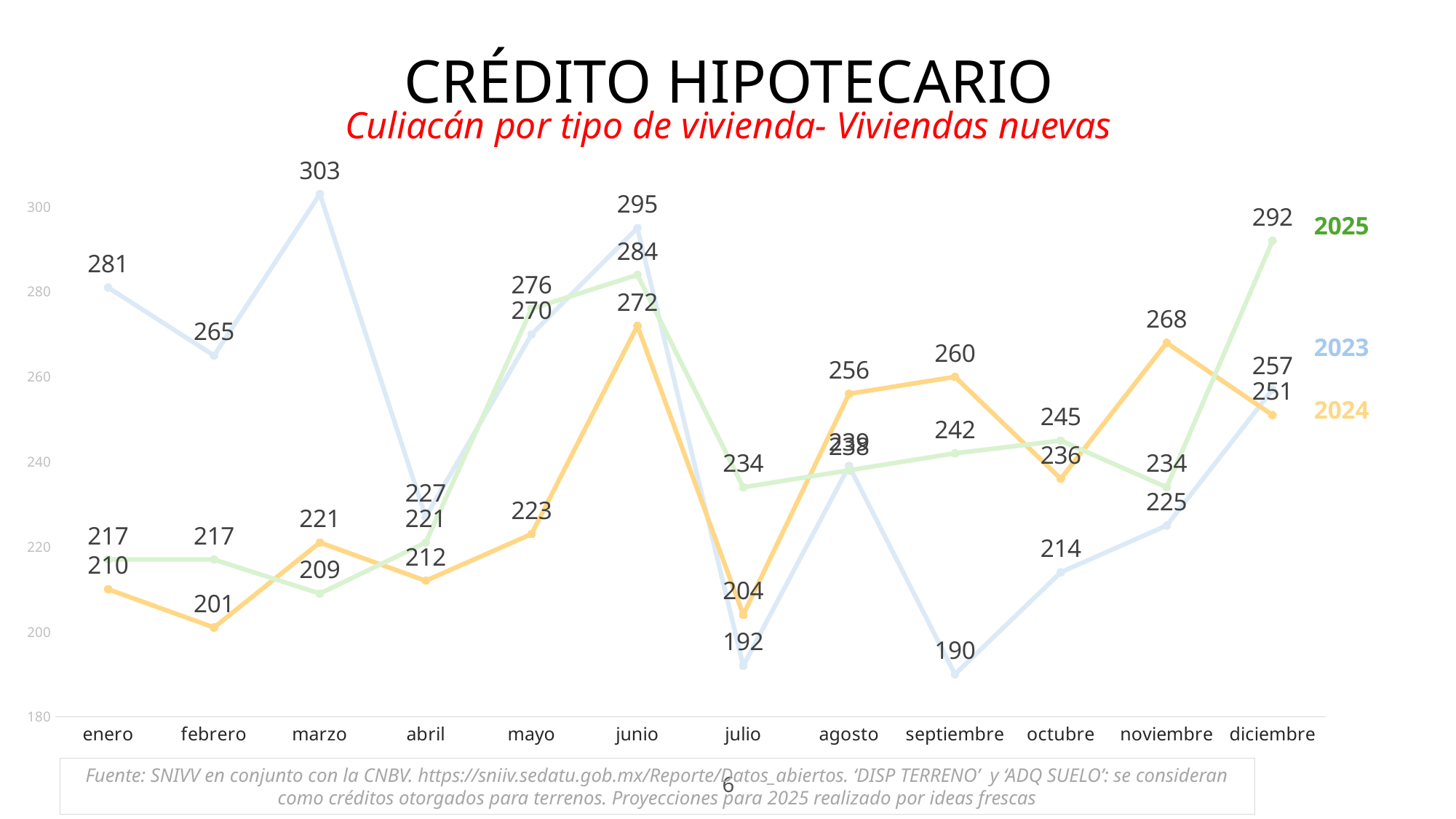
What is the value for 2024 in noviembre? 268 What is the value for 2025 in diciembre? 292 How many series does the chart show? 3 In junio, which series has the larger value, 2024 or 2025? 2025 In which month is the 2024 series lowest? febrero What is the value for 2023 in marzo? 303 What kind of chart is shown on the slide? line chart In which month is the 2023 series highest? marzo What is the difference between the 2023 and 2024 values in enero? 71 How many months are plotted along the x axis? 12 In which month is the 2023 series lowest? septiembre Does the 2025 series rise or fall from marzo to junio? rise